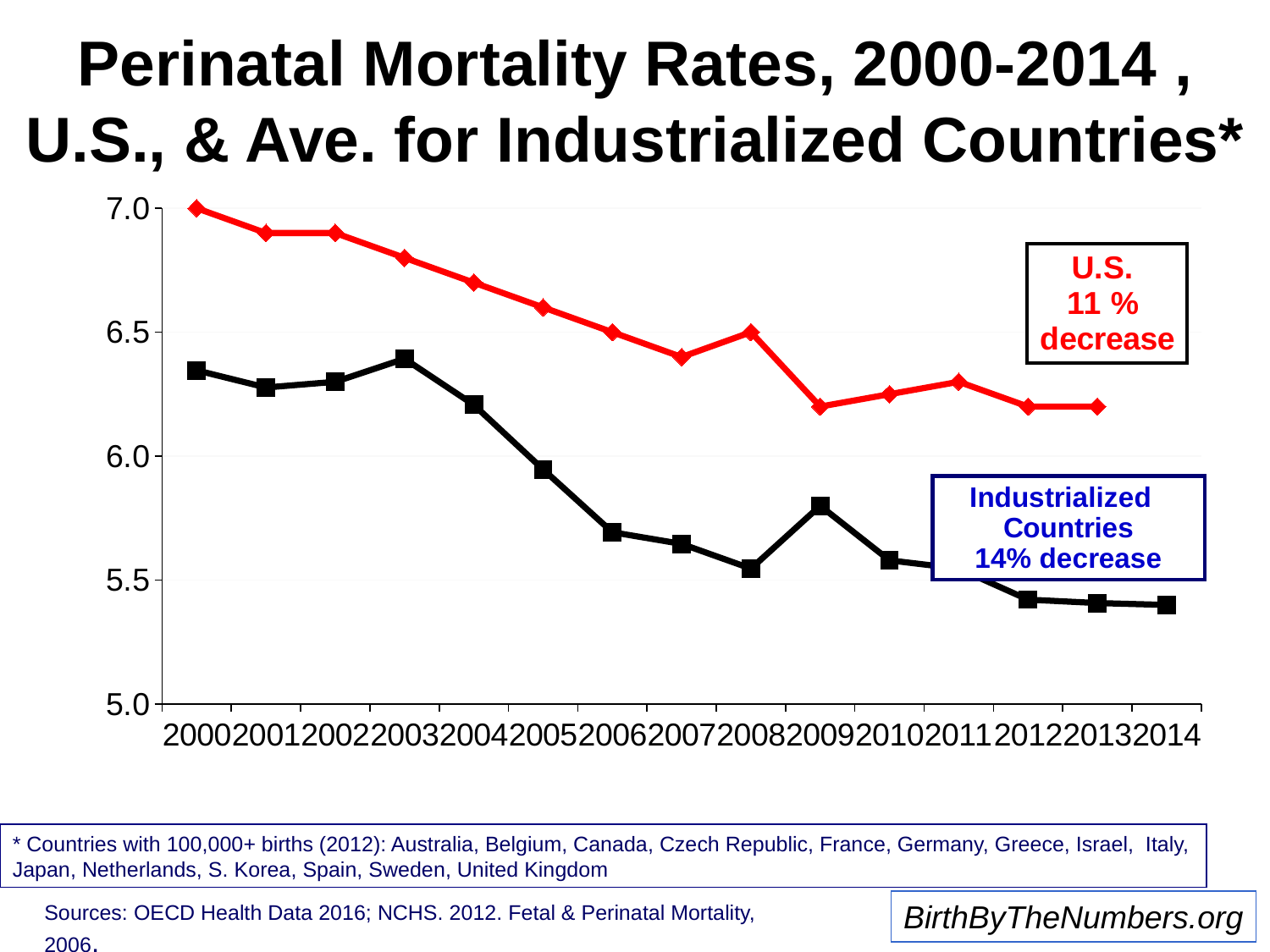
Do the Industrialized Countries values generally rise or fall from 2000 to 2014? fall Is the U.S. value for 2013 greater or less than 6.5? less In which year is the U.S. perinatal mortality rate highest? 2000 How many data series are plotted on the chart? 2 Is the Industrialized Countries value for 2014 greater or less than 5.5? less In 2010, which series has the higher perinatal mortality rate, U.S. or Industrialized Countries? U.S. What kind of chart is shown on the slide? line chart What is the U.S. perinatal mortality rate in 2006? 6.5 Is the Industrialized Countries value for 2000 greater or less than 6.0? greater How many years are labelled along the x axis? 15 What is the U.S. perinatal mortality rate in 2000? 7.0 What percentage decrease does the chart annotation give for the Industrialized Countries? 14% decrease